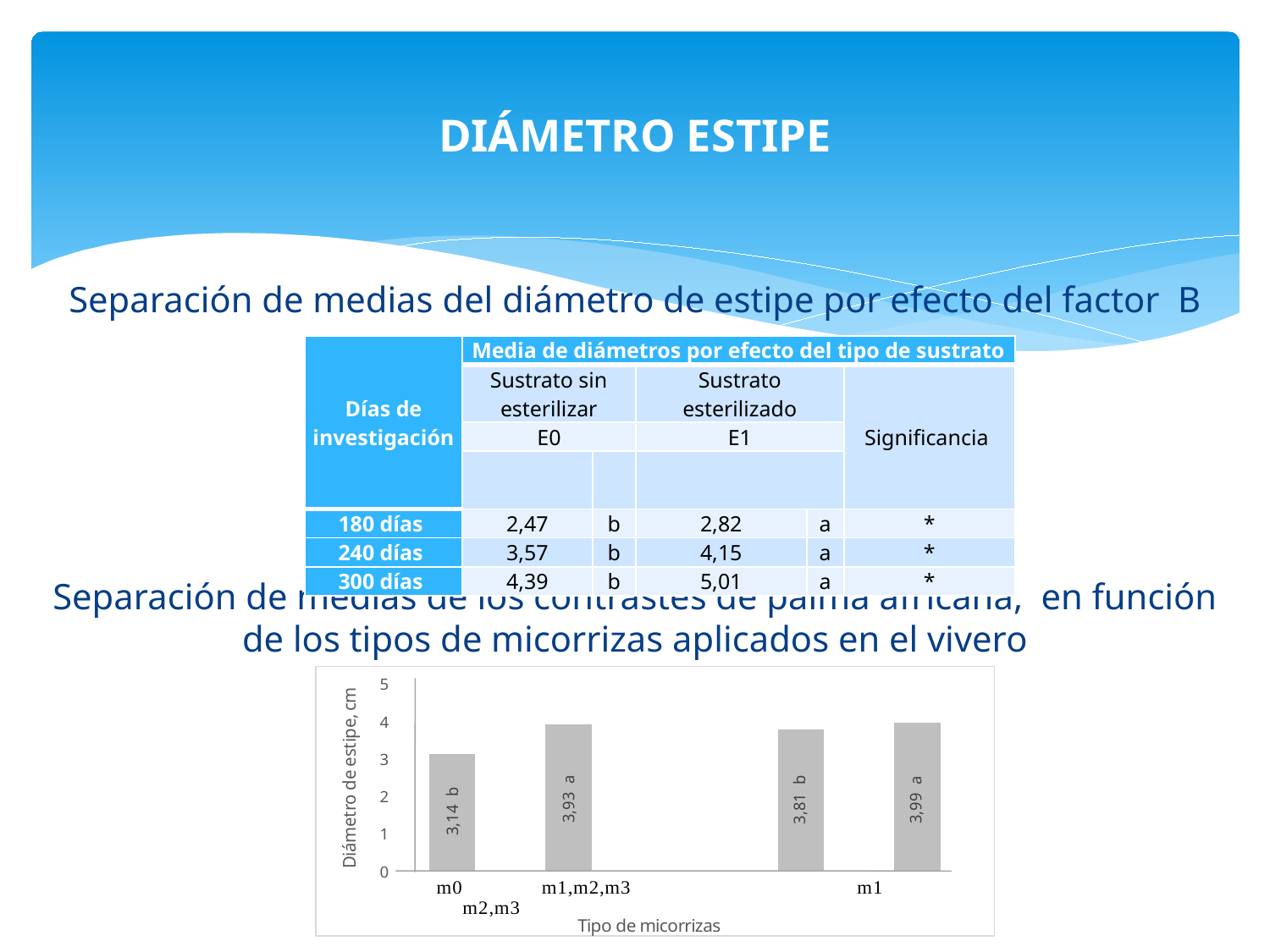
What kind of chart is shown on the slide? bar chart Is the value for m0 greater or less than 4? less What is the highest value shown on any bar? 3,99 What is the difference between the highest bar value (3,99) and the bar for m0 (3,14)? 0,85 What is the value of the third bar from the left? 3,81 What is the value of the rightmost bar? 3,99 Which bar has the lowest value? m0 What is the title of the vertical axis of the chart? Diámetro de estipe, cm Which is larger, the bar for m0 or the bar for m1,m2,m3? m1,m2,m3 What is the value of the bar for m1,m2,m3? 3,93 How many bars are plotted in the chart? 4 What is the value of the bar for m0? 3,14